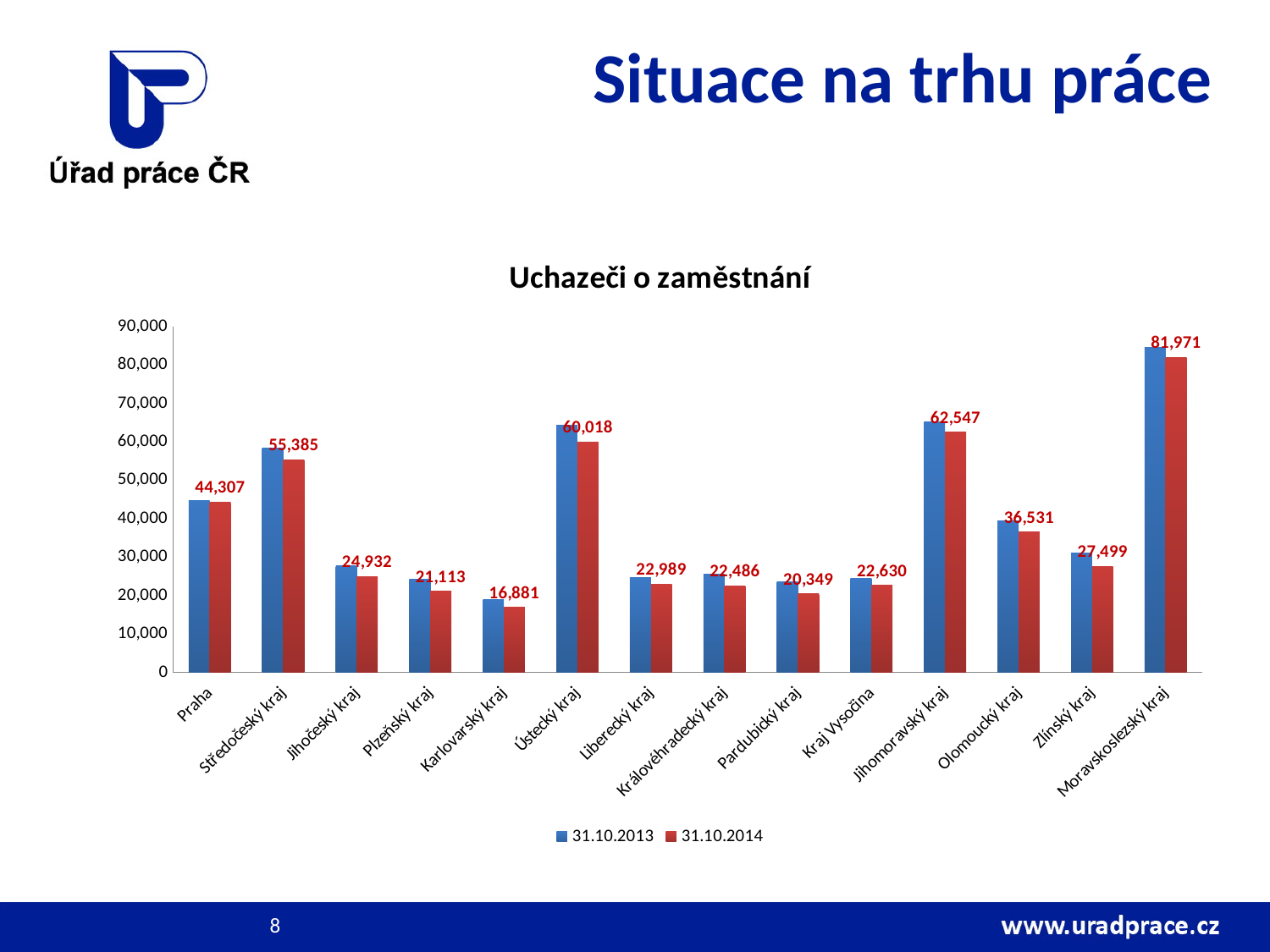
How many series does the legend list? 2 How many regions are shown on the x axis? 14 What is the difference between the 31.10.2014 values for Jihomoravský kraj and Ústecký kraj? 2,529 What kind of chart is shown? bar chart Which region has the highest value in the 31.10.2014 series? Moravskoslezský kraj Is the 31.10.2013 value for Moravskoslezský kraj greater or less than 80,000? greater What is the value for Karlovarský kraj in the 31.10.2014 series? 16,881 What is the value for Moravskoslezský kraj in the 31.10.2014 series? 81,971 Which region has the lowest value in the 31.10.2014 series? Karlovarský kraj What is the value for Praha in the 31.10.2014 series? 44,307 Which is larger in the 31.10.2014 series: Středočeský kraj or Olomoucký kraj? Středočeský kraj What is the title of the chart? Uchazeči o zaměstnání